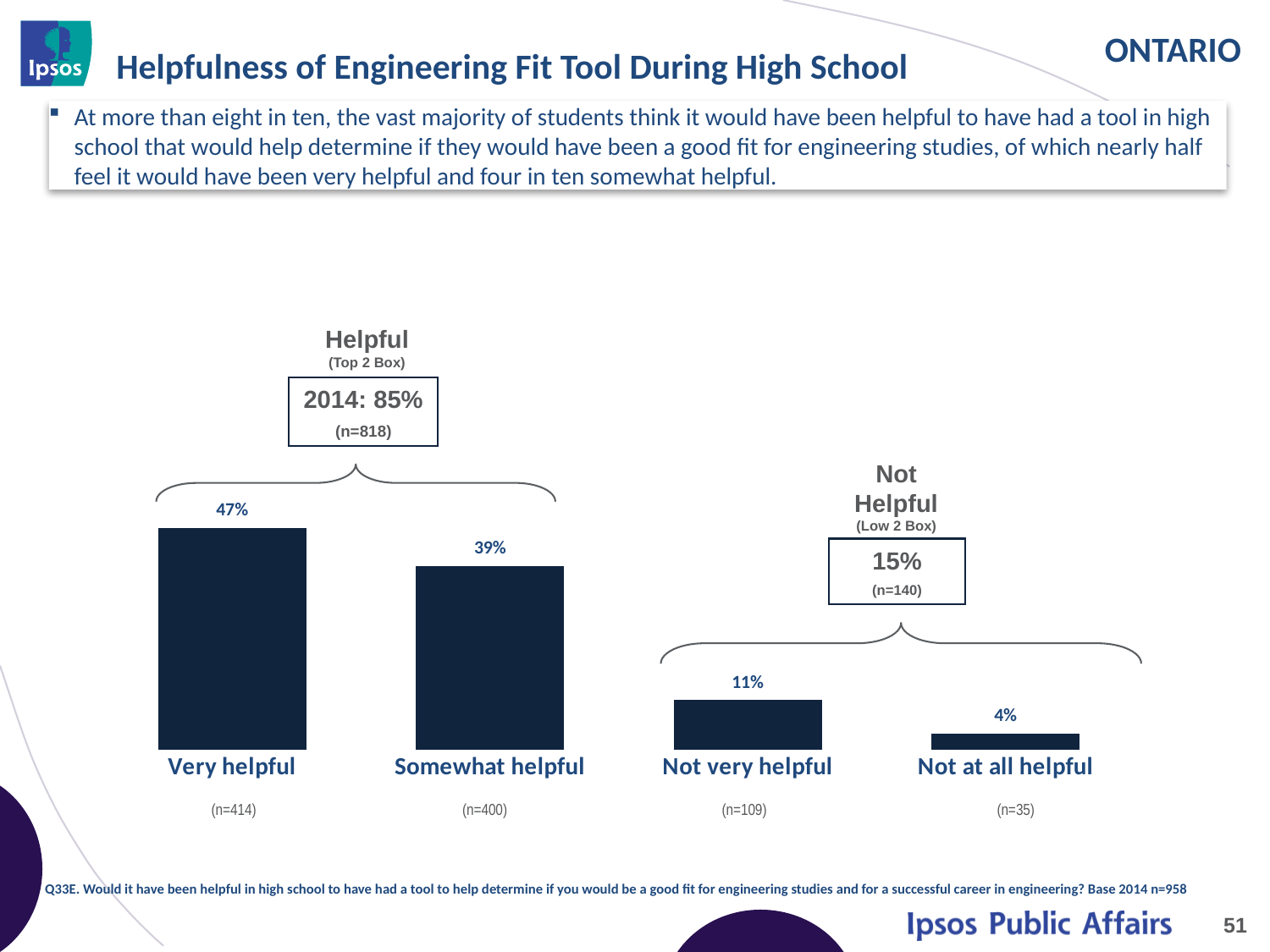
What is the Not Helpful (Low 2 Box) percentage shown? 15% What is the value for Not very helpful? 11% How many categories are shown in the chart? 4 Which category has the lowest value? Not at all helpful What is the value for Somewhat helpful? 39% What kind of chart is shown on the slide? Bar chart What is the value for Not at all helpful? 4% What is the Helpful (Top 2 Box) percentage shown for 2014? 85% Which is larger, the value for Not very helpful or the value for Not at all helpful? Not very helpful What percentage of students said a tool would have been very helpful? 47% What is the difference between the Very helpful and Somewhat helpful values? 8% Which category has the highest value? Very helpful